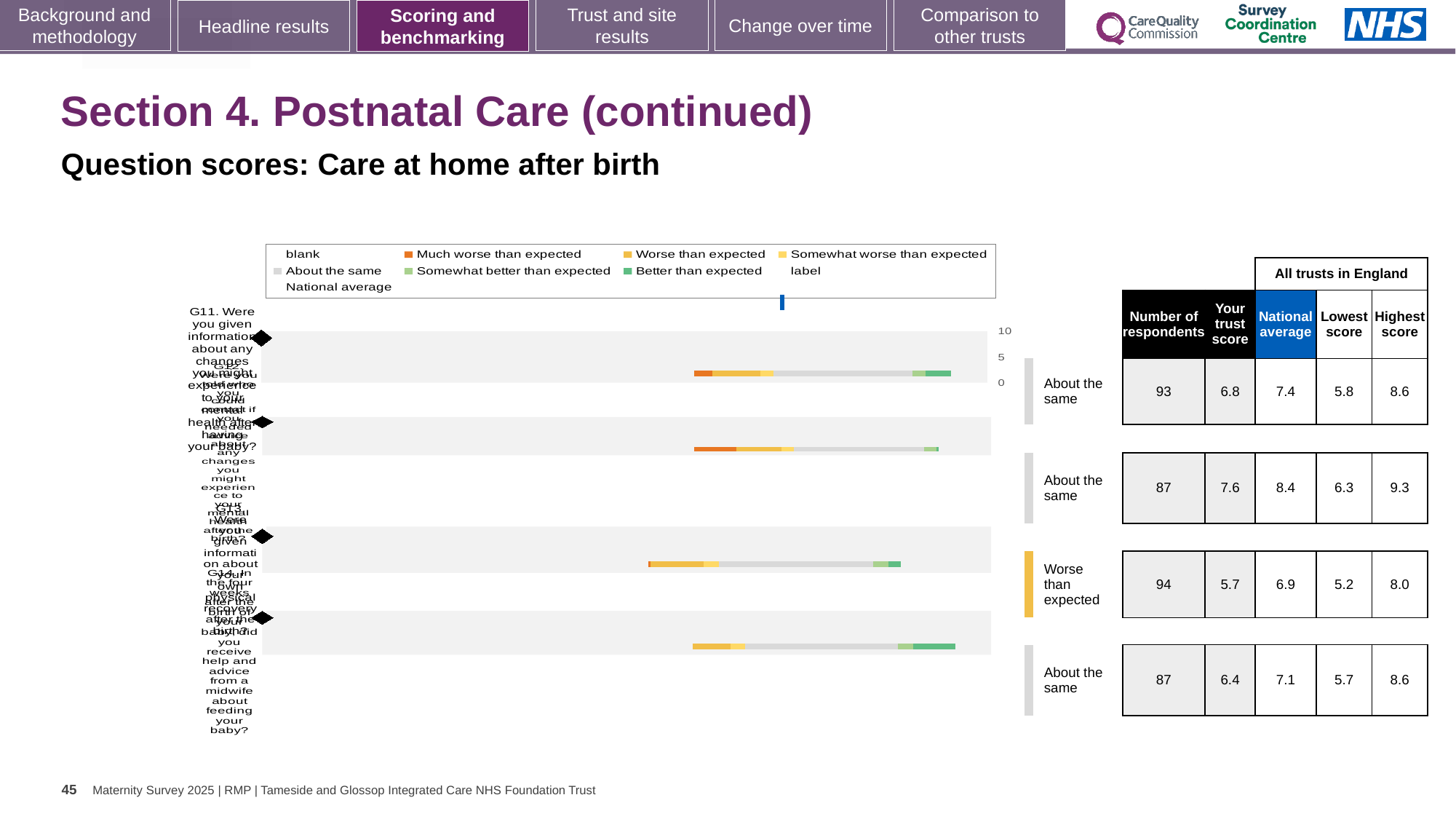
What kind of chart is shown on the slide? bar chart What is the lowest score for the fourth (bottom) question in the table? 5.7 Which question row has the highest national average in the table? the second row (8.4) Which question row in the table is rated 'Worse than expected'? the third row In the table beside the chart, what is the trust score for the first (top) question? 6.8 For the first (top) question, what is the difference between the national average and the trust score? 0.6 In the table beside the chart, what is the national average for the second question? 8.4 For the fourth (bottom) question, is the trust score larger or smaller than the national average? smaller How many question bars are plotted in the chart? 4 In the table beside the chart, what is the highest score for the third question? 8.0 Which question row has the lowest trust score in the table? the third row (5.7) In the table beside the chart, what is the number of respondents for the first (top) question? 93